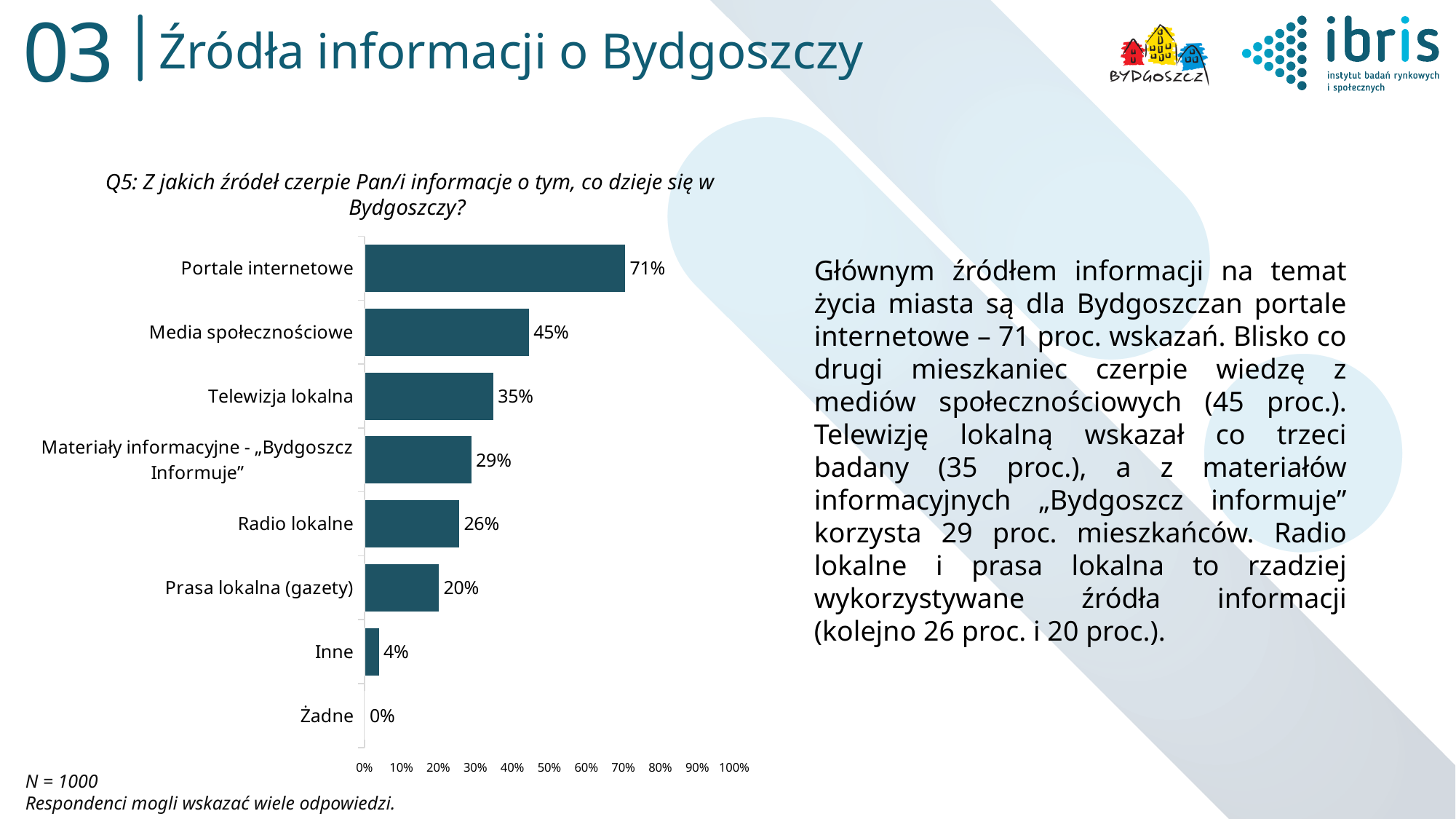
Which category has the lowest value in the chart? Żadne What is the difference between Telewizja lokalna and Prasa lokalna (gazety)? 15% What type of chart is shown on the slide? Bar chart Which category has the highest value in the chart? Portale internetowe What is the difference between the values for Portale internetowe and Media społecznościowe? 26% What percentage is shown for Radio lokalne? 26% How many categories are shown in the chart? 8 What is the sample size (N) stated on the slide? N = 1000 Which is larger: the value for Telewizja lokalna or the value for Radio lokalne? Telewizja lokalna What is the value for Inne? 4% What percentage of respondents indicated Portale internetowe as a source of information? 71% What is the value shown for Media społecznościowe? 45%